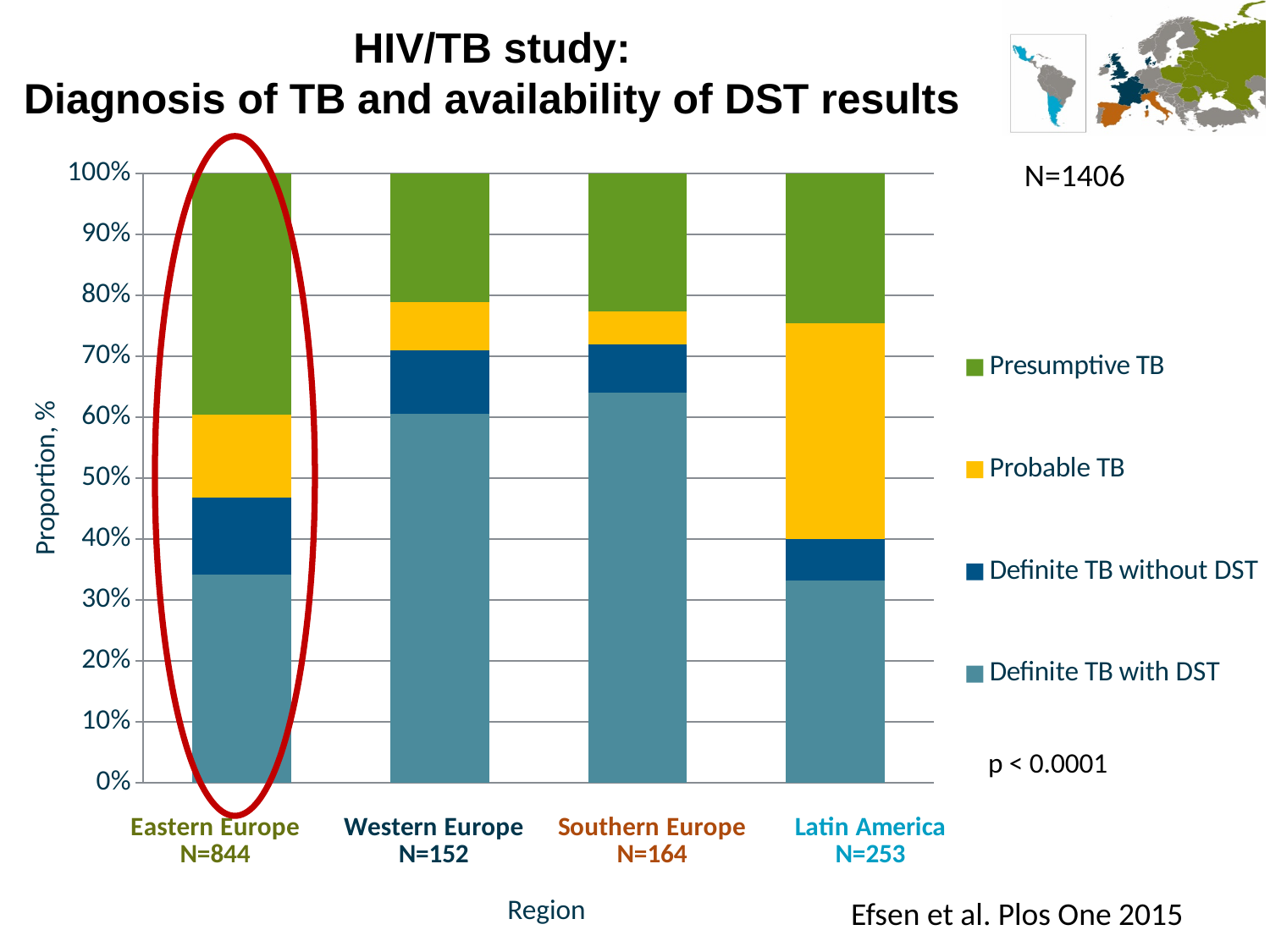
Which region has the largest Presumptive TB segment? Eastern Europe Is the Definite TB without DST segment larger for Eastern Europe or for Latin America? Eastern Europe How many series does the chart legend list? 4 How many regions are shown on the x axis of the chart? 4 Is the Definite TB with DST segment larger for Southern Europe or for Latin America? Southern Europe Is the Definite TB with DST proportion for Western Europe greater or less than 50%? greater What is the total height of the Eastern Europe stacked bar? 100% What kind of chart is shown on the slide? Stacked bar chart Is the Definite TB with DST proportion for Eastern Europe greater or less than 40%? less Is the Definite TB with DST proportion for Latin America greater or less than 40%? less What is the N shown under the Eastern Europe category label? N=844 Which region has the largest Probable TB segment? Latin America